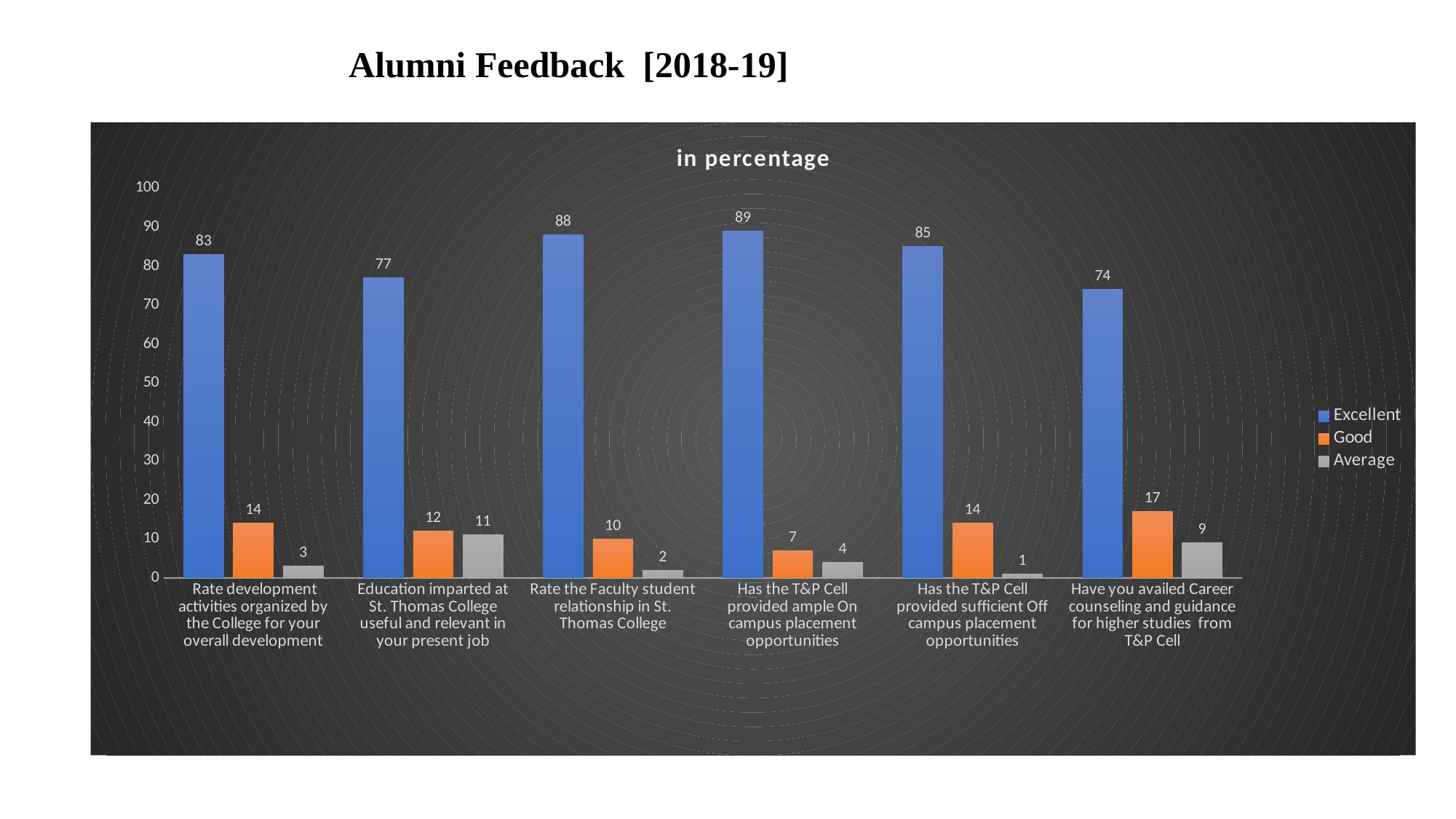
What is the difference between the Excellent values for "Rate the Faculty student relationship in St. Thomas College" and "Have you availed Career counseling and guidance for higher studies from T&P Cell"? 14 What is the Good value for "Have you availed Career counseling and guidance for higher studies from T&P Cell"? 17 What kind of chart is shown on the slide? bar chart Which category has the lowest Average value? Has the T&P Cell provided sufficient Off campus placement opportunities How many series does the legend list? 3 Which is larger: the Good value for "Rate development activities organized by the College for your overall development" or the Good value for "Rate the Faculty student relationship in St. Thomas College"? Rate development activities organized by the College for your overall development How many categories are shown on the x axis? 6 What is the title shown inside the chart area? in percentage What is the Average value for "Education imparted at St. Thomas College useful and relevant in your present job"? 11 Which category has the highest Excellent value? Has the T&P Cell provided ample On campus placement opportunities What is the Excellent value for "Has the T&P Cell provided ample On campus placement opportunities"? 89 Is the Excellent value for "Education imparted at St. Thomas College useful and relevant in your present job" greater or less than 80? less